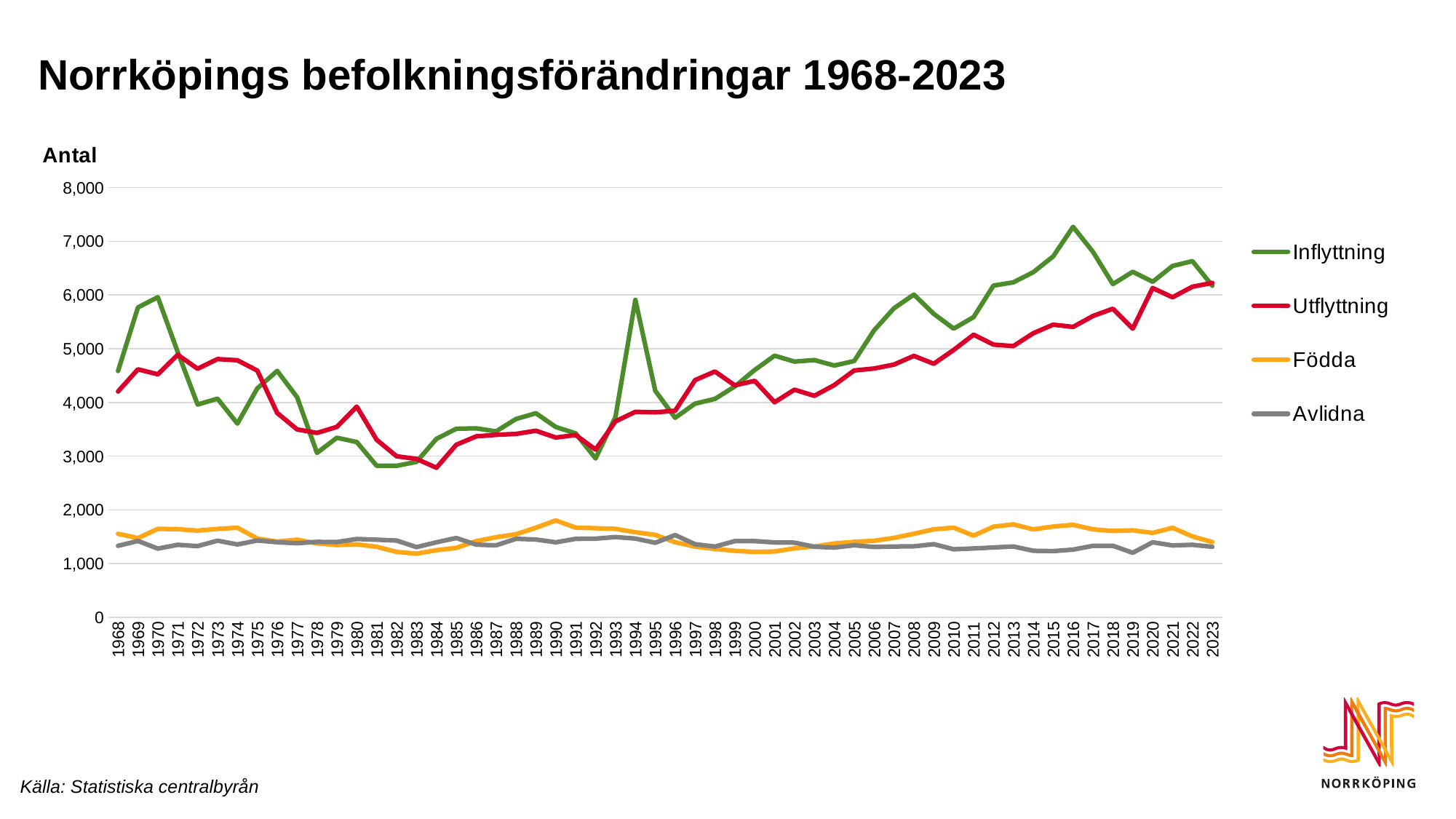
Is the value for Inflyttning in 2016 greater or less than 7,000? greater What colour is the Födda line in the legend? orange In 1984, which is larger, Inflyttning or Utflyttning? Inflyttning Is the value for Utflyttning in 1984 greater or less than 3,000? less In 2016, which is larger, Inflyttning or Utflyttning? Inflyttning Does the Utflyttning line generally rise or fall from 2000 to 2023? rise How many years are plotted along the x axis? 56 In which year does the Inflyttning line reach its highest value? 2016 Is the value for Inflyttning in 1994 greater or less than 5,000? greater What kind of chart is shown on the slide? line chart How many series does the legend list? 4